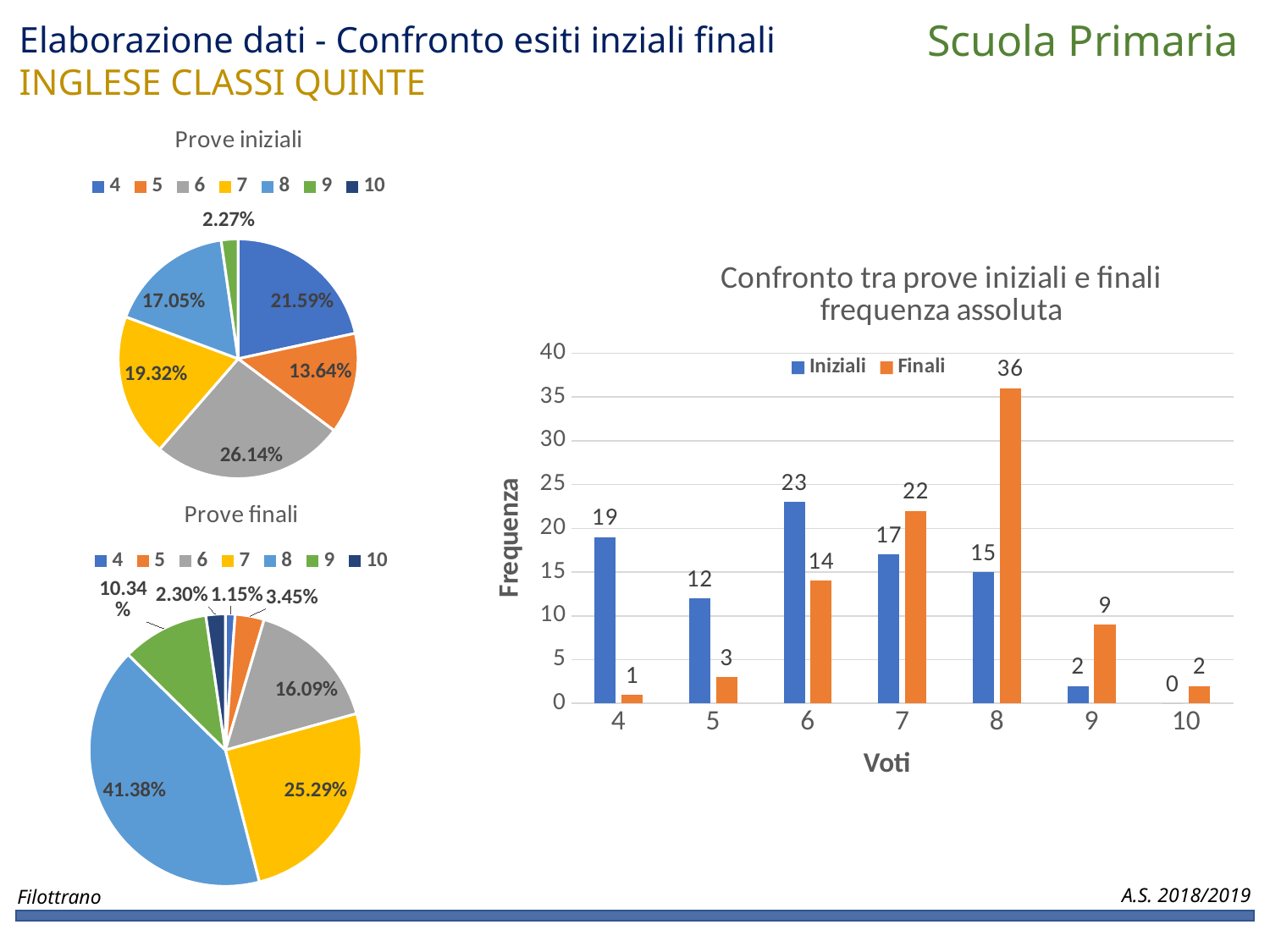
In the 'Confronto tra prove iniziali e finali frequenza assoluta' bar chart, which is larger for voto 7: Iniziali or Finali? Finali In the 'Confronto tra prove iniziali e finali frequenza assoluta' bar chart, which voto has the highest Iniziali value? 6 In the 'Prove iniziali' pie chart, what percentage is shown for voto 7? 19.32% In the 'Confronto tra prove iniziali e finali frequenza assoluta' bar chart, what is the Iniziali value for voto 6? 23 In the 'Prove finali' pie chart, what share does voto 8 have? 41.38% What kind of chart is 'Confronto tra prove iniziali e finali frequenza assoluta'? Bar chart In the 'Confronto tra prove iniziali e finali frequenza assoluta' bar chart, which voto has the lowest Finali value? 4 In the 'Prove iniziali' pie chart, which voto has the largest slice? 6 In the 'Confronto tra prove iniziali e finali frequenza assoluta' bar chart, what is the difference between the Finali and Iniziali values for voto 8? 21 In the 'Confronto tra prove iniziali e finali frequenza assoluta' bar chart, how many voti categories are shown on the x axis? 7 In the 'Confronto tra prove iniziali e finali frequenza assoluta' bar chart, how many series does the legend list? 2 In the 'Confronto tra prove iniziali e finali frequenza assoluta' bar chart, what is the Finali value for voto 8? 36